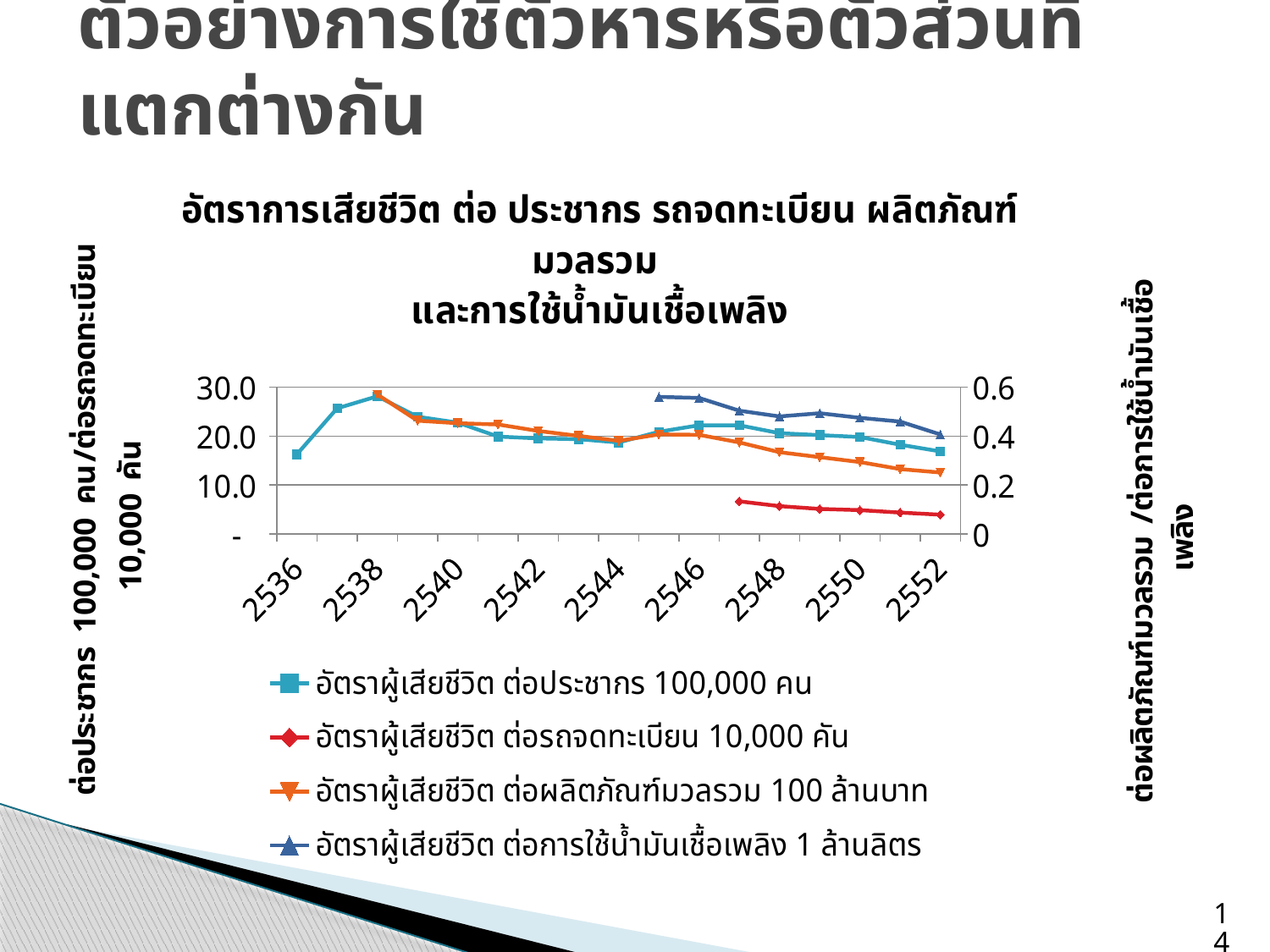
At 2552, which is larger: อัตราผู้เสียชีวิต ต่อประชากร 100,000 คน or อัตราผู้เสียชีวิต ต่อรถจดทะเบียน 10,000 คัน? อัตราผู้เสียชีวิต ต่อประชากร 100,000 คน What kind of chart is shown on the slide? line chart Does the series อัตราผู้เสียชีวิต ต่อรถจดทะเบียน 10,000 คัน rise or fall from 2547 to 2552? fall On the right axis, is the value for 2552 in the series อัตราผู้เสียชีวิต ต่อผลิตภัณฑ์มวลรวม 100 ล้านบาท greater or less than 0.4? less In which year does the series อัตราผู้เสียชีวิต ต่อประชากร 100,000 คน reach its highest value? 2538 Is the value for 2552 in the series อัตราผู้เสียชีวิต ต่อรถจดทะเบียน 10,000 คัน greater or less than 10.0? less Does the series อัตราผู้เสียชีวิต ต่อการใช้น้ำมันเชื้อเพลิง 1 ล้านลิตร rise or fall from 2545 to 2552? fall Is the value for 2536 in the series อัตราผู้เสียชีวิต ต่อประชากร 100,000 คน greater or less than 20.0? less Which series is drawn with triangle markers in dark blue? อัตราผู้เสียชีวิต ต่อการใช้น้ำมันเชื้อเพลิง 1 ล้านลิตร How many series does the legend list? 4